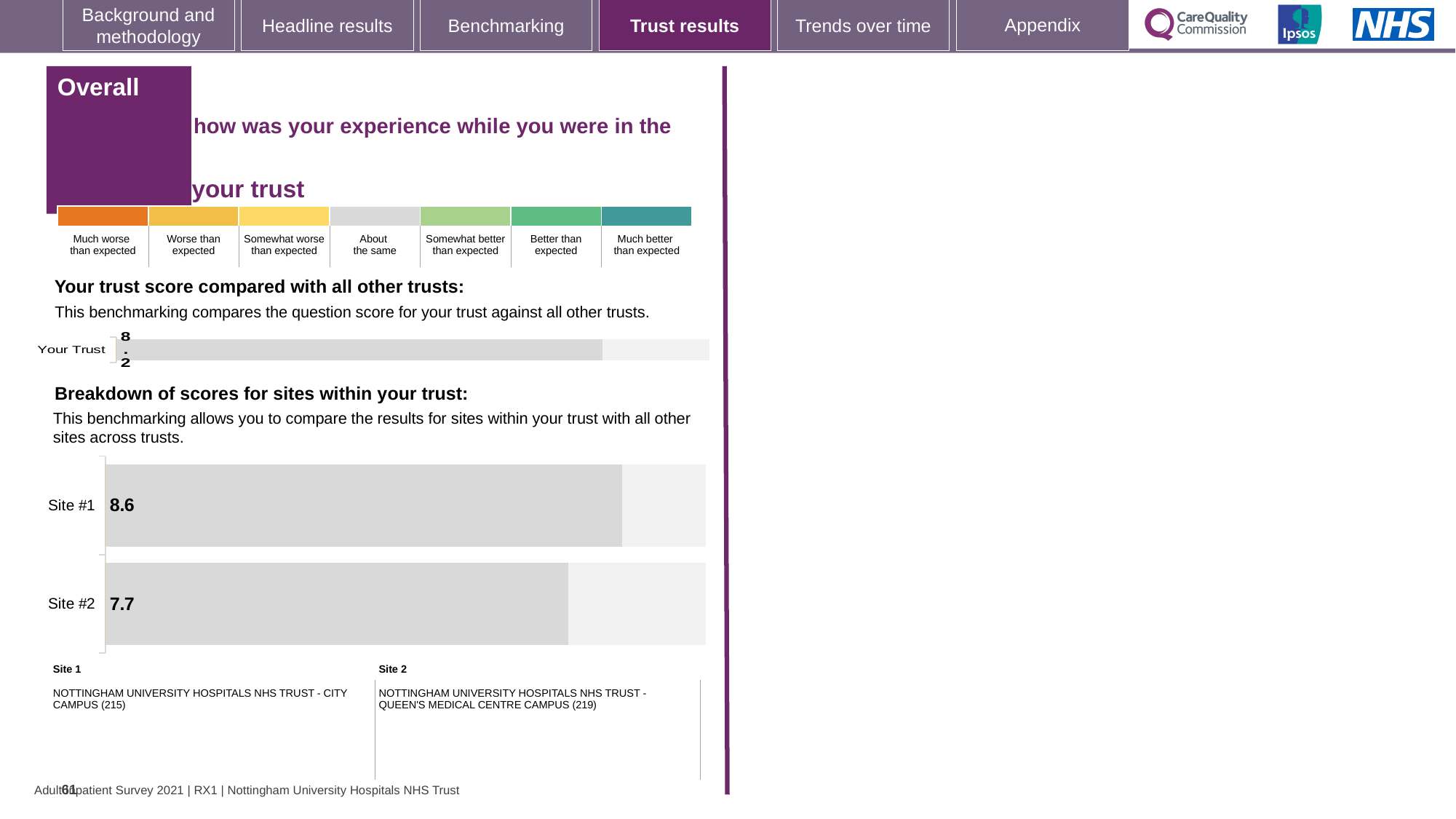
In the 'Breakdown of scores for sites within your trust' chart, which site has the highest score? Site #1 Which site in the 'Breakdown of scores for sites within your trust' chart corresponds to the Queen's Medical Centre Campus? Site 2 In the 'Breakdown of scores for sites within your trust' chart, what is the score for Site #1? 8.6 How many categories are plotted in the 'Your trust score compared with all other trusts' chart? 1 In the 'Your trust score compared with all other trusts' chart, what is the score shown for Your Trust? 8.2 In the 'Breakdown of scores for sites within your trust' chart, which has the larger score, Site #1 or Site #2? Site #1 In the 'Breakdown of scores for sites within your trust' chart, which site has the lowest score? Site #2 What kind of chart is the 'Breakdown of scores for sites within your trust' chart? Bar chart In the 'Breakdown of scores for sites within your trust' chart, what is the difference between the scores for Site #1 and Site #2? 0.9 How many sites are shown in the 'Breakdown of scores for sites within your trust' chart? 2 In the 'Breakdown of scores for sites within your trust' chart, what is the score for Site #2? 7.7 Is the Site #1 score in the 'Breakdown of scores for sites within your trust' chart greater or less than the Your Trust score in the 'Your trust score compared with all other trusts' chart? greater